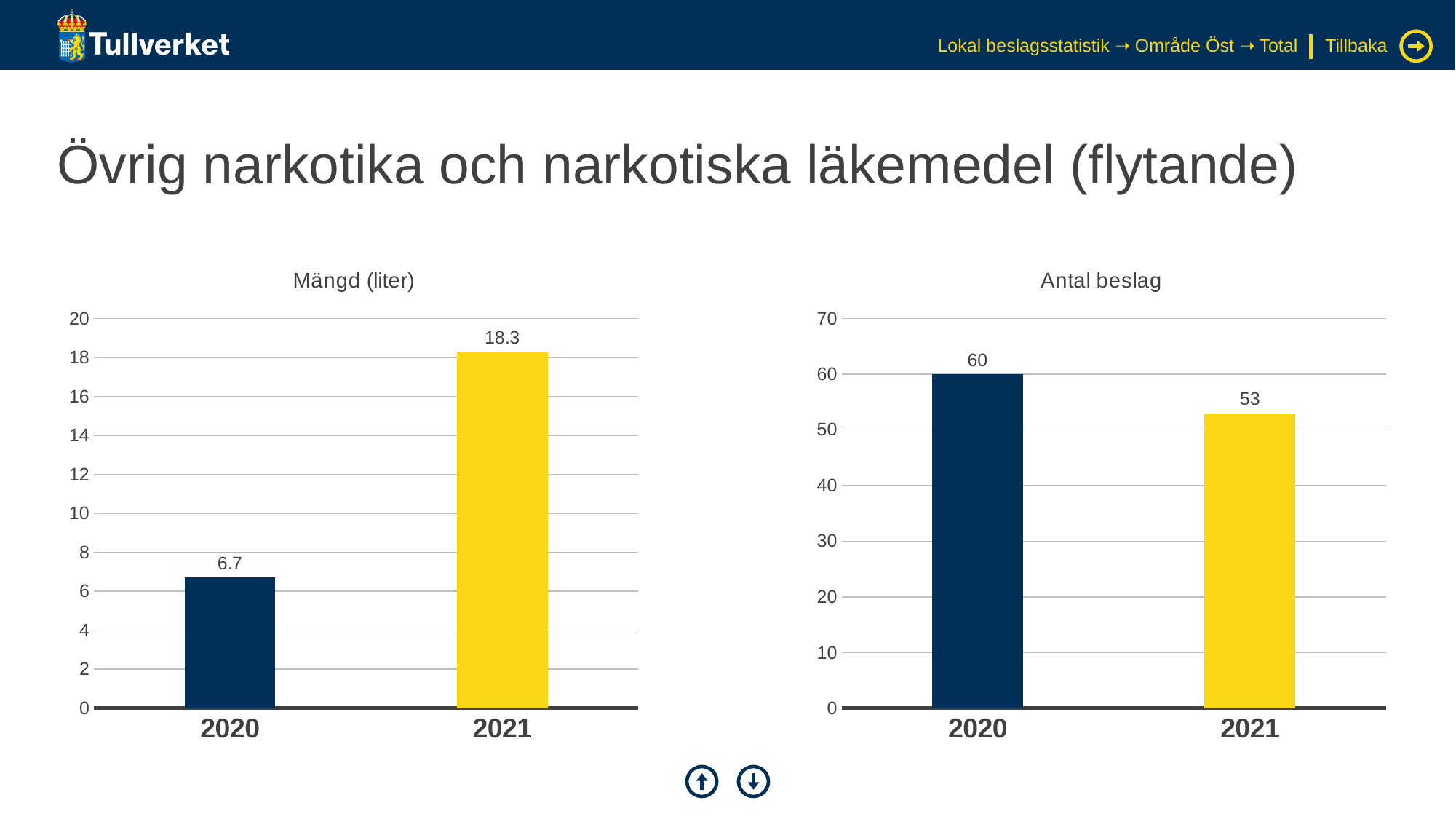
In the 'Mängd (liter)' chart, what is the value for 2021? 18.3 In the 'Antal beslag' chart, what is the value for 2020? 60 How many categories are shown on the x axis of the 'Antal beslag' chart? 2 In the 'Antal beslag' chart, what is the difference between the 2020 and 2021 values? 7 In the 'Antal beslag' chart, what is the value for 2021? 53 What kind of chart is the 'Mängd (liter)' chart? bar chart In the 'Mängd (liter)' chart, which year has the highest value? 2021 In the 'Mängd (liter)' chart, do the values rise or fall from 2020 to 2021? rise In the 'Mängd (liter)' chart, what is the value for 2020? 6.7 In the 'Antal beslag' chart, which year has the lowest value? 2021 In the 'Mängd (liter)' chart, what is the difference between the 2021 and 2020 values? 11.6 In the 'Antal beslag' chart, is the value for 2020 larger or smaller than the value for 2021? larger